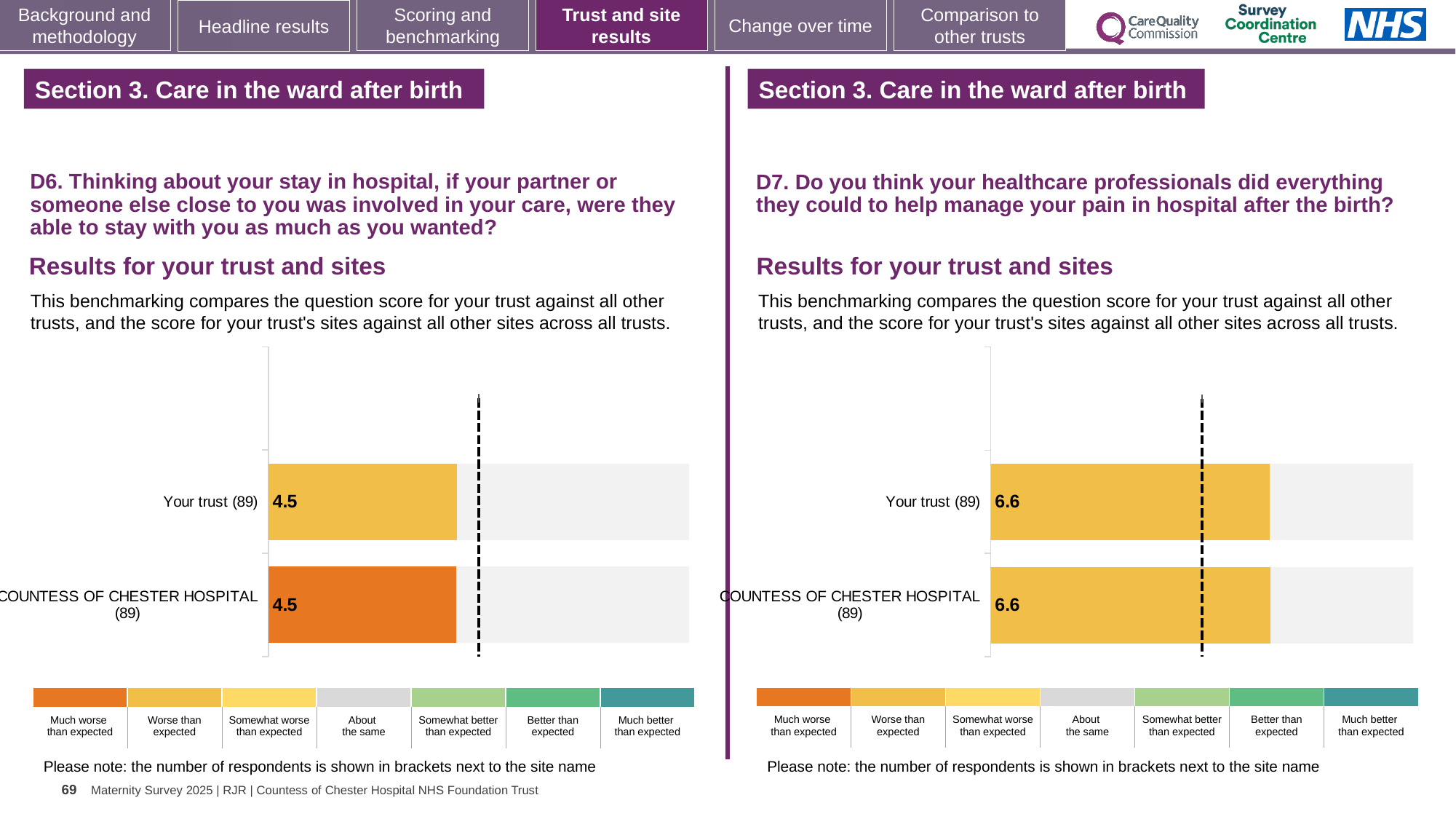
In the D7 chart on the right, what is the difference between the score for Your trust and the score for Countess of Chester Hospital? 0.0 In the D6 chart on the left, how many respondents are shown in brackets for Your trust? 89 In the D6 chart on the left, what is the score for Your trust? 4.5 In the D6 chart on the left, what is the score for Countess of Chester Hospital? 4.5 In the D6 chart on the left, what is the difference between the score for Your trust and the score for Countess of Chester Hospital? 0.0 How many bars are plotted in the D6 chart on the left? 2 How many bars are plotted in the D7 chart on the right? 2 In the D7 chart on the right, what is the score for Countess of Chester Hospital? 6.6 In the D7 chart on the right, which benchmark category does the colour of the Your trust bar correspond to? Worse than expected In the D6 chart on the left, which benchmark category does the colour of the Countess of Chester Hospital bar correspond to? Much worse than expected In the D7 chart on the right, what is the score for Your trust? 6.6 What type of chart is the D6 chart on the left? Bar chart